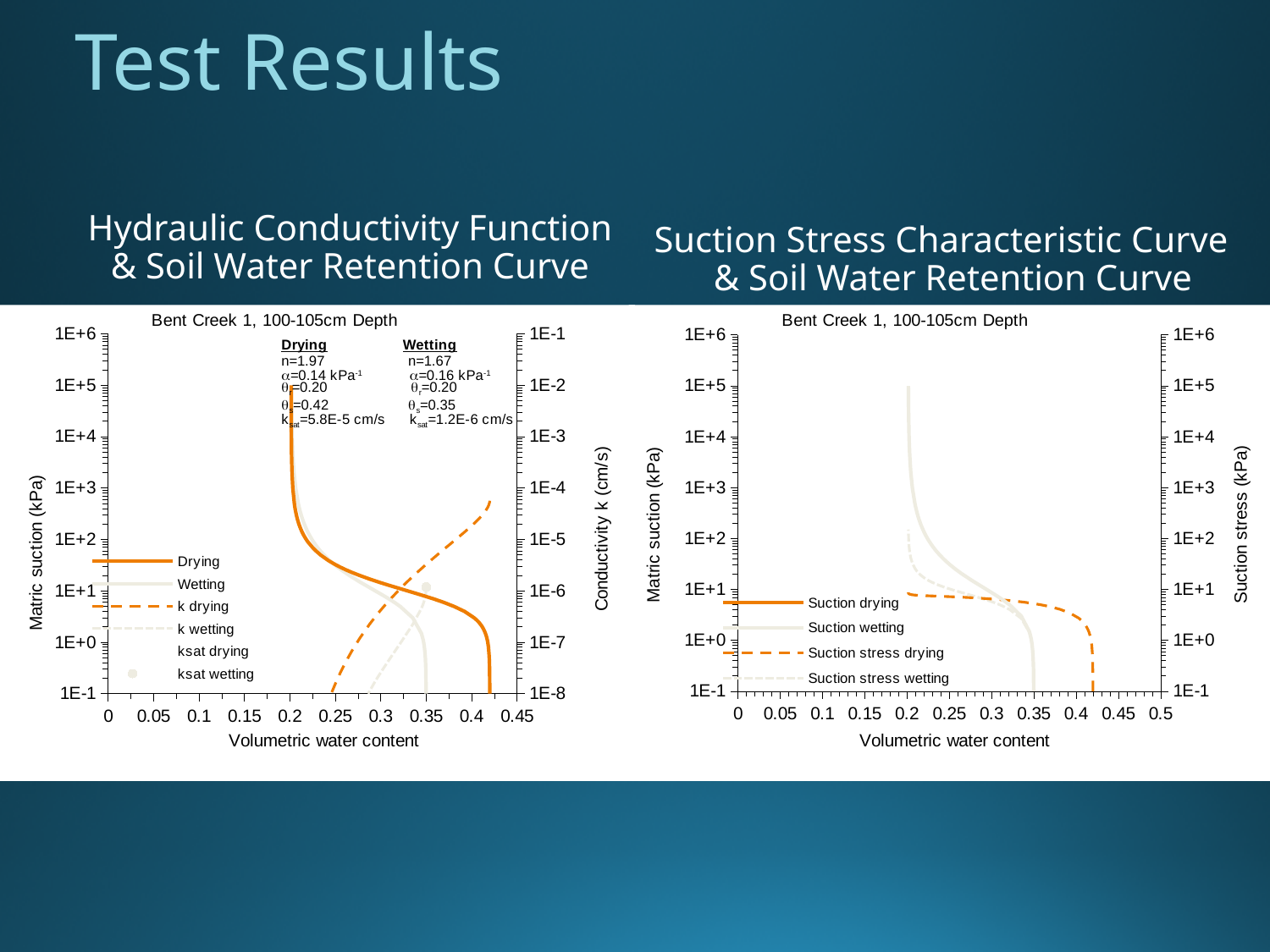
On the left chart, what is the ksat value given for Drying? 5.8E-5 cm/s What is the chart title printed above the left chart? Bent Creek 1, 100-105cm Depth On the left chart, what is the θs value given for the Wetting curve? 0.35 On the left chart, which has the larger ksat value, Drying or Wetting? Drying On the right chart, does the Suction drying curve rise or fall in matric suction as volumetric water content increases? fall On the left chart, what is the n value given for the Wetting curve? n=1.67 On the right chart, what is the label of the right-hand vertical axis? Suction stress (kPa) On the left chart, what is the n value given for the Drying curve? n=1.97 On the left chart, what is the ksat value given for Wetting? 1.2E-6 cm/s What kind of chart is shown on the left side of the slide? line chart How many series does the legend of the right chart (Suction Stress Characteristic Curve) list? 4 How many series does the legend of the left chart list? 6